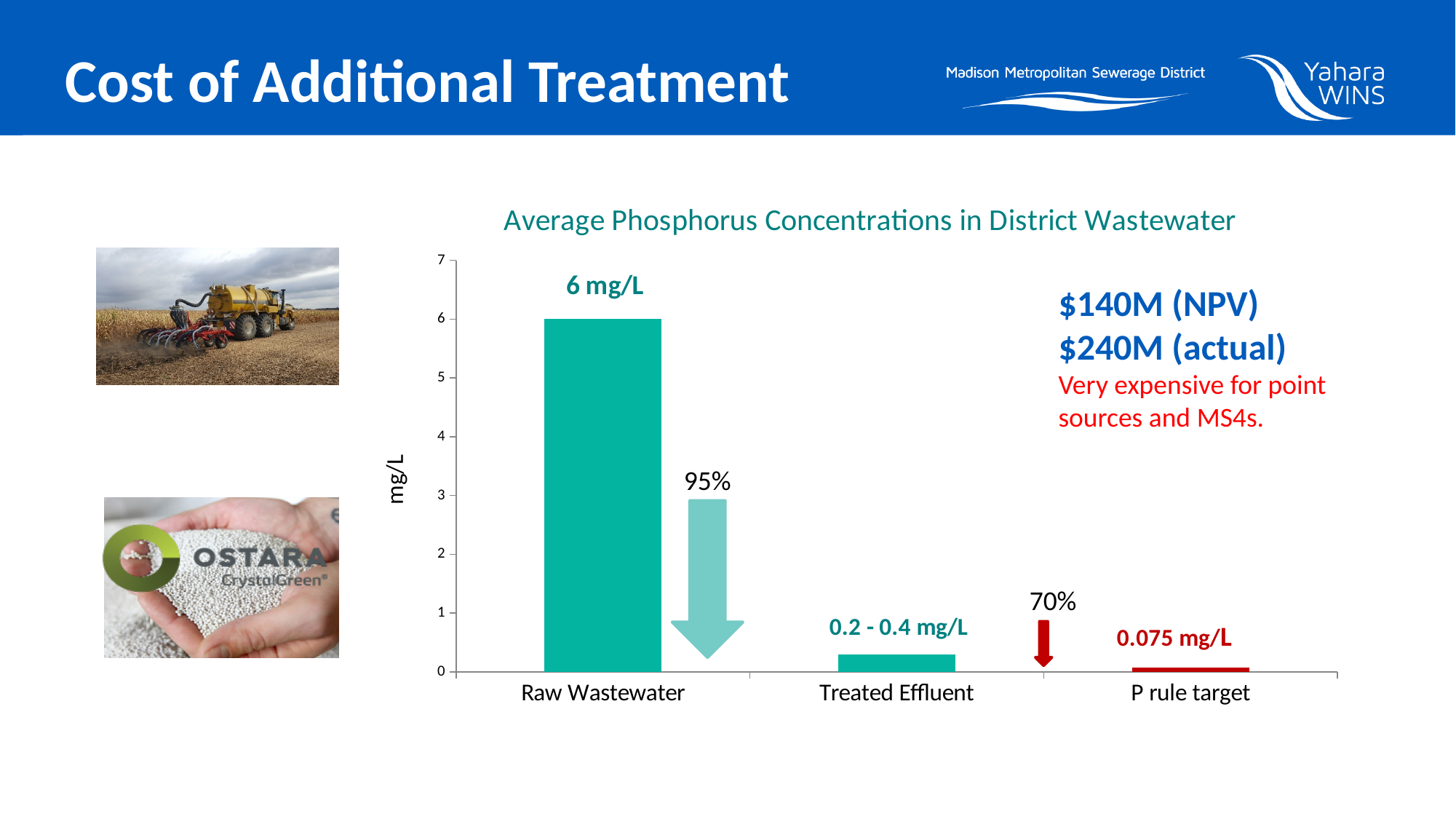
What is the value shown for P rule target? 0.075 mg/L Do the values rise or fall from left to right along the x axis? fall Is the value for Treated Effluent greater or less than 1? less What is the value shown for Raw Wastewater? 6 mg/L Which category has the highest phosphorus concentration? Raw Wastewater What is the title of the chart? Average Phosphorus Concentrations in District Wastewater What value is labelled for Treated Effluent? 0.2 - 0.4 mg/L Is the value for Raw Wastewater greater or less than 5? greater Which is larger, the value for Raw Wastewater or the value for Treated Effluent? Raw Wastewater What kind of chart is shown on the slide? bar chart How many categories are shown on the x axis? 3 Which category has the lowest phosphorus concentration? P rule target